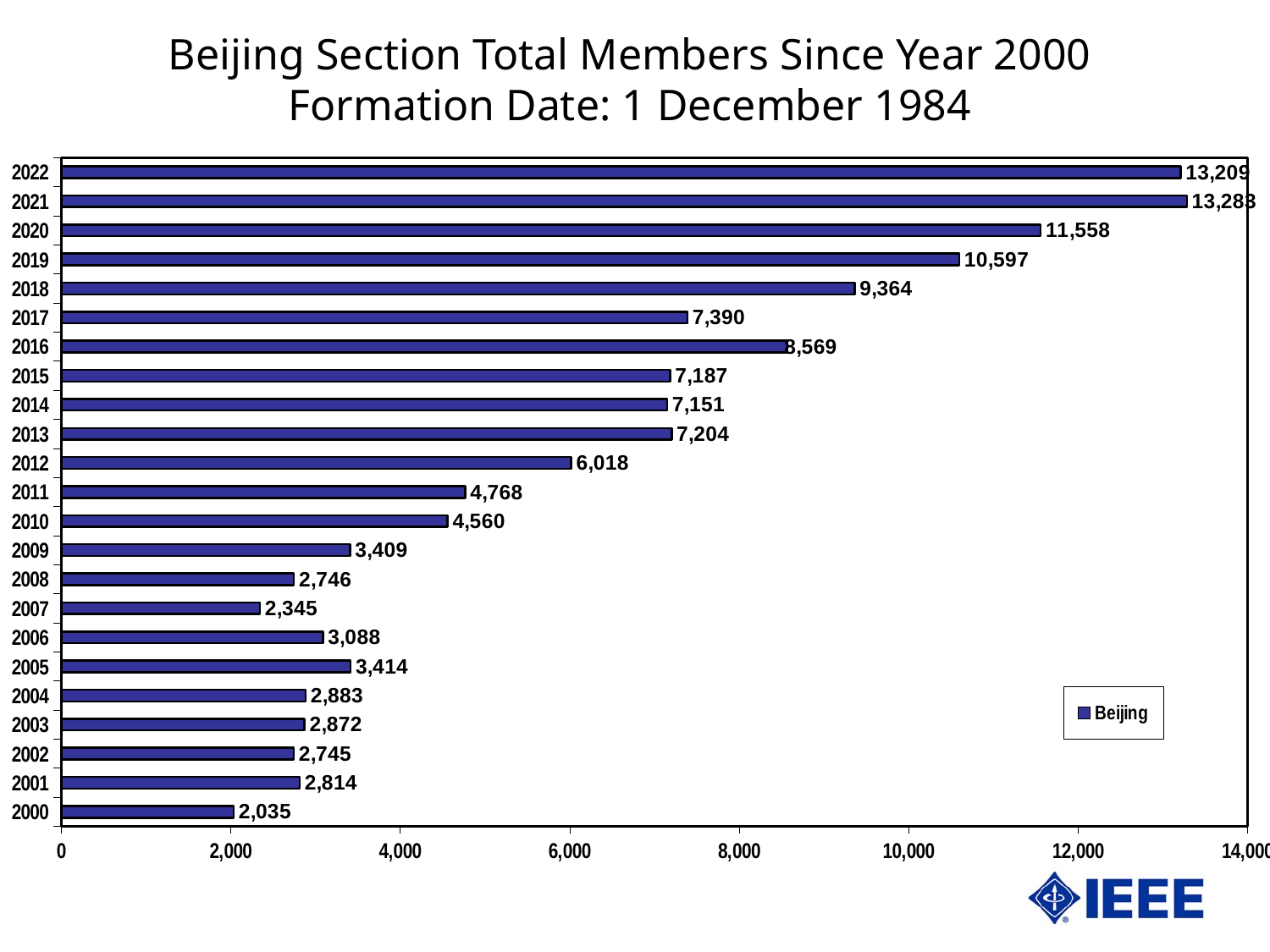
How many series does the legend list? 1 Which year has the lowest value? 2000 What is the value for 2000? 2,035 Which is larger, the value for 2017 or the value for 2016? 2016 What type of chart is shown on the slide? bar chart What is the difference between the values for 2020 and 2019? 961 Is the value for 2018 greater or less than 8,000? greater How many years are shown on the chart? 23 What is the value for 2022? 13,209 What is the value for 2012? 6,018 What is the value for 2016? 8,569 What is the name of the series shown in the legend? Beijing